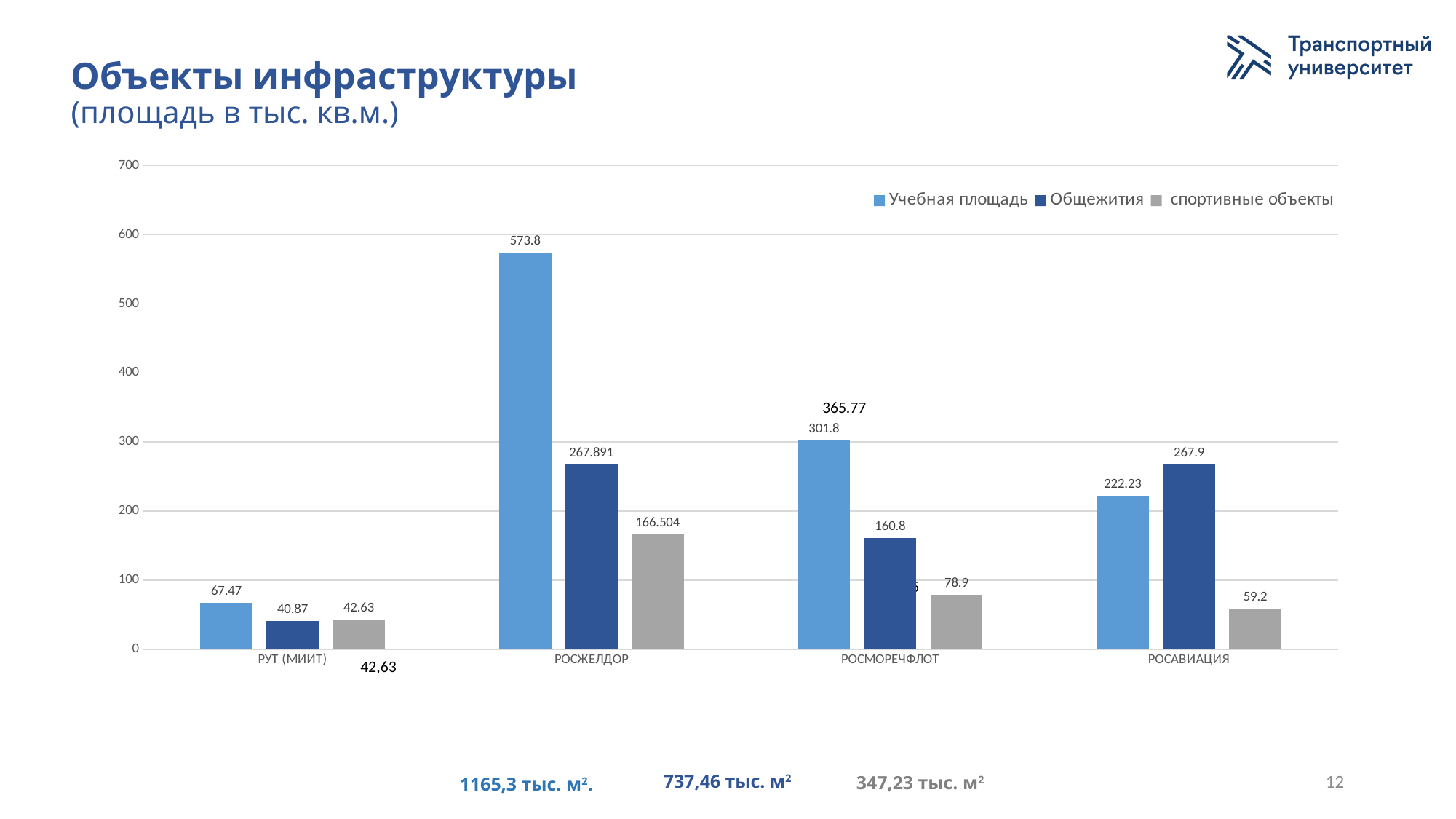
What is the value of Учебная площадь for РОСЖЕЛДОР? 573.8 Which category has the highest value for Учебная площадь? РОСЖЕЛДОР Which category has the lowest value for Общежития? РУТ (МИИТ) How many categories are shown on the x axis? 4 What is the value of Общежития for РОСАВИАЦИЯ? 267.9 Which is larger for РОСАВИАЦИЯ: Учебная площадь or Общежития? Общежития What is the difference between Учебная площадь for РОСЖЕЛДОР and Учебная площадь for РОСАВИАЦИЯ? 351.57 Is the value of спортивные объекты for РОСАВИАЦИЯ greater or less than 100? less What is the value of Учебная площадь for РУТ (МИИТ)? 67.47 What kind of chart is shown on the slide? bar chart What is the value of спортивные объекты for РОСЖЕЛДОР? 166.504 How many series does the legend list? 3